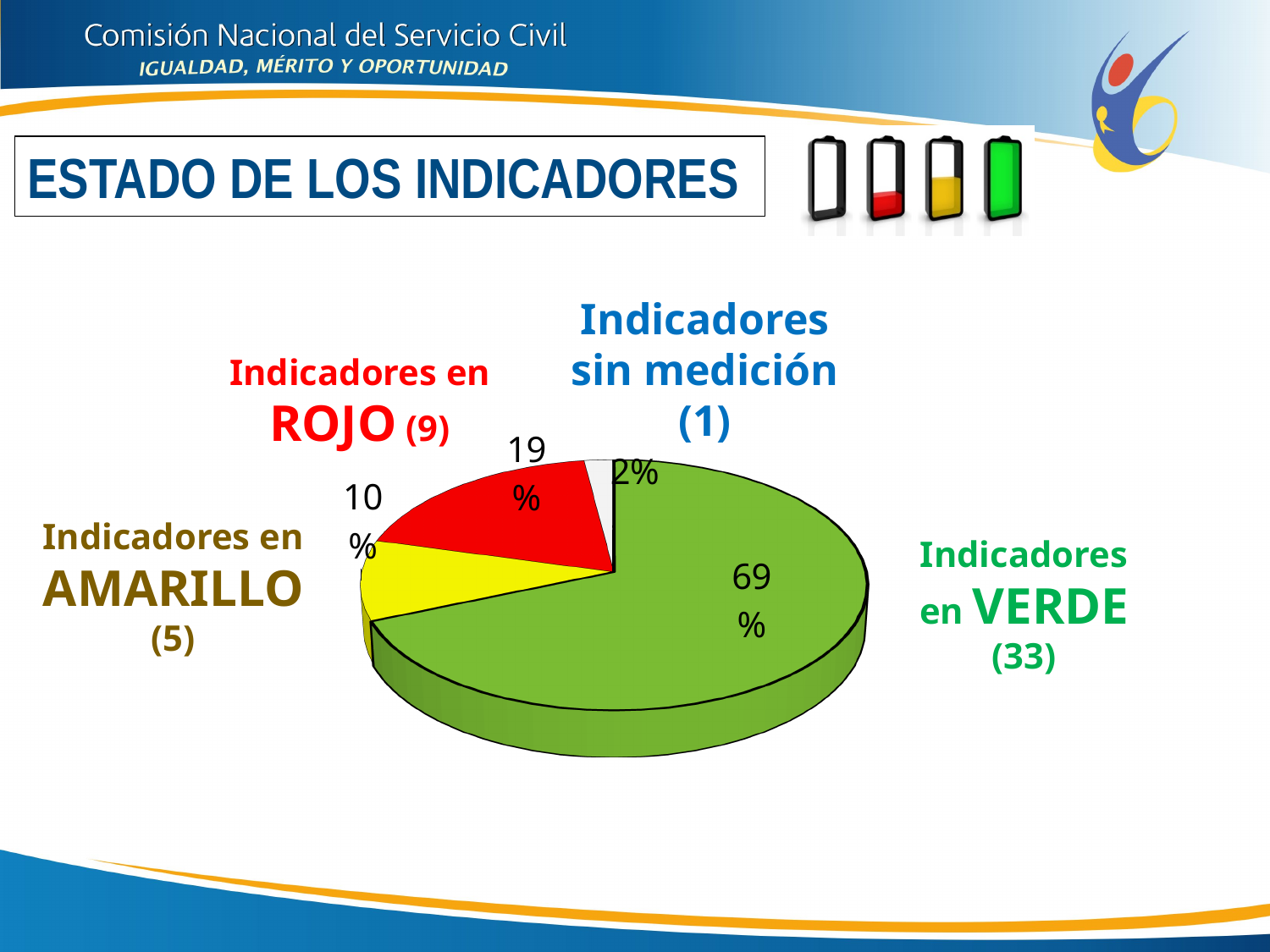
Which category has the largest slice of the pie? Indicadores en VERDE How many indicators are in the 'Indicadores en ROJO' category? 9 What kind of chart is shown on the slide? pie chart Which category has the smallest slice of the pie? Indicadores sin medición What percentage share does the 'Indicadores en ROJO' slice have? 19% Which is larger, the ROJO slice or the AMARILLO slice? ROJO What percentage share does the 'Indicadores sin medición' slice have? 2% How many indicators are in the 'Indicadores en VERDE' category? 33 How many slices does the pie chart have? 4 What percentage share does the 'Indicadores en AMARILLO' slice have? 10% What is the difference in percentage points between the VERDE slice and the ROJO slice? 50